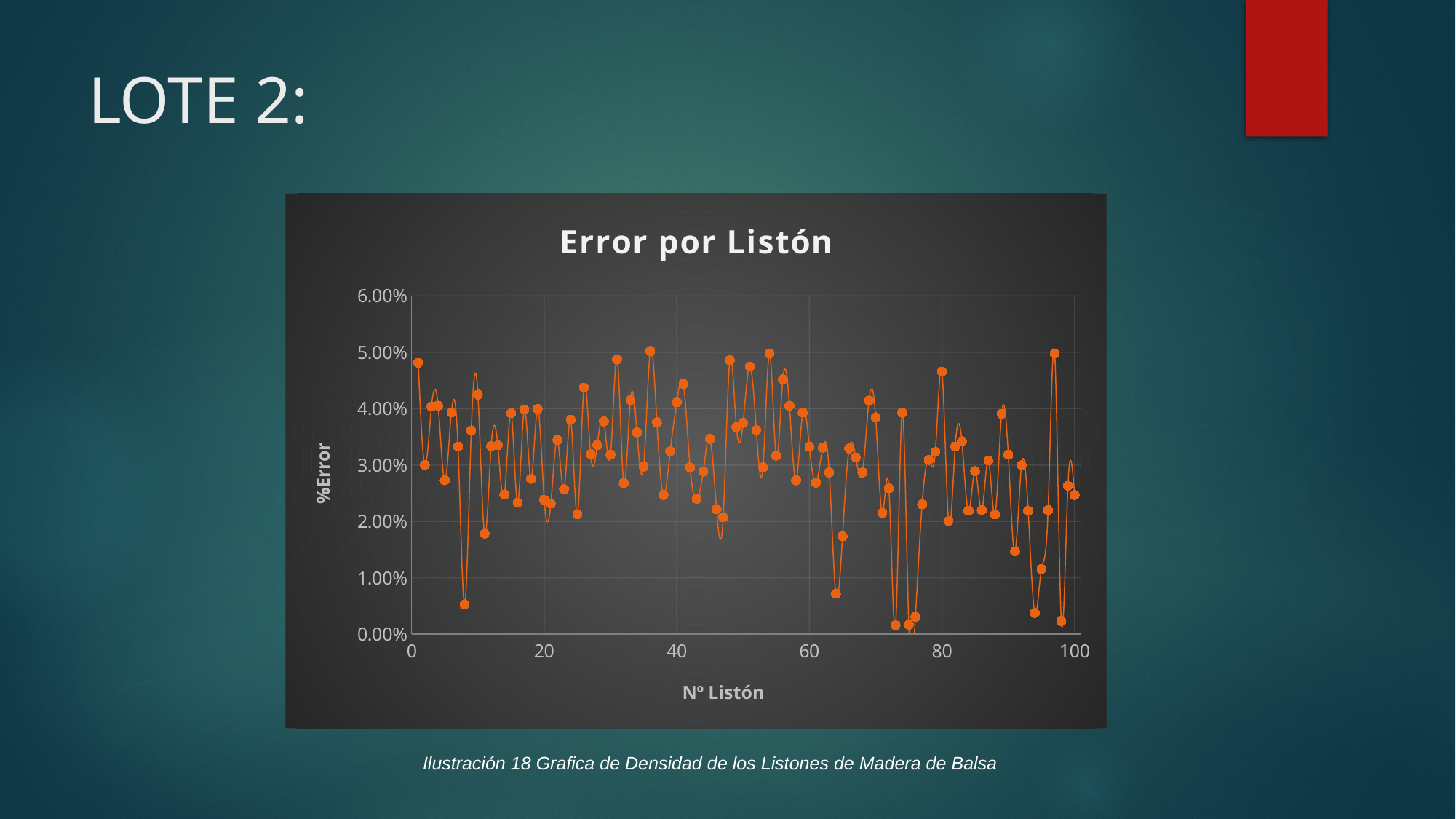
Is the value for Nº Listón 73 greater or less than 1.00%? less Is the value for Nº Listón 97 greater or less than 4.00%? greater What is the label of the x axis of the chart? Nº Listón What kind of chart is shown on the slide? line chart What is the title of the chart? Error por Listón Is the value for Nº Listón 1 greater or less than 4.00%? greater Which is larger, the value for Nº Listón 1 or the value for Nº Listón 8? Nº Listón 1 Which is larger, the value for Nº Listón 73 or the value for Nº Listón 80? Nº Listón 80